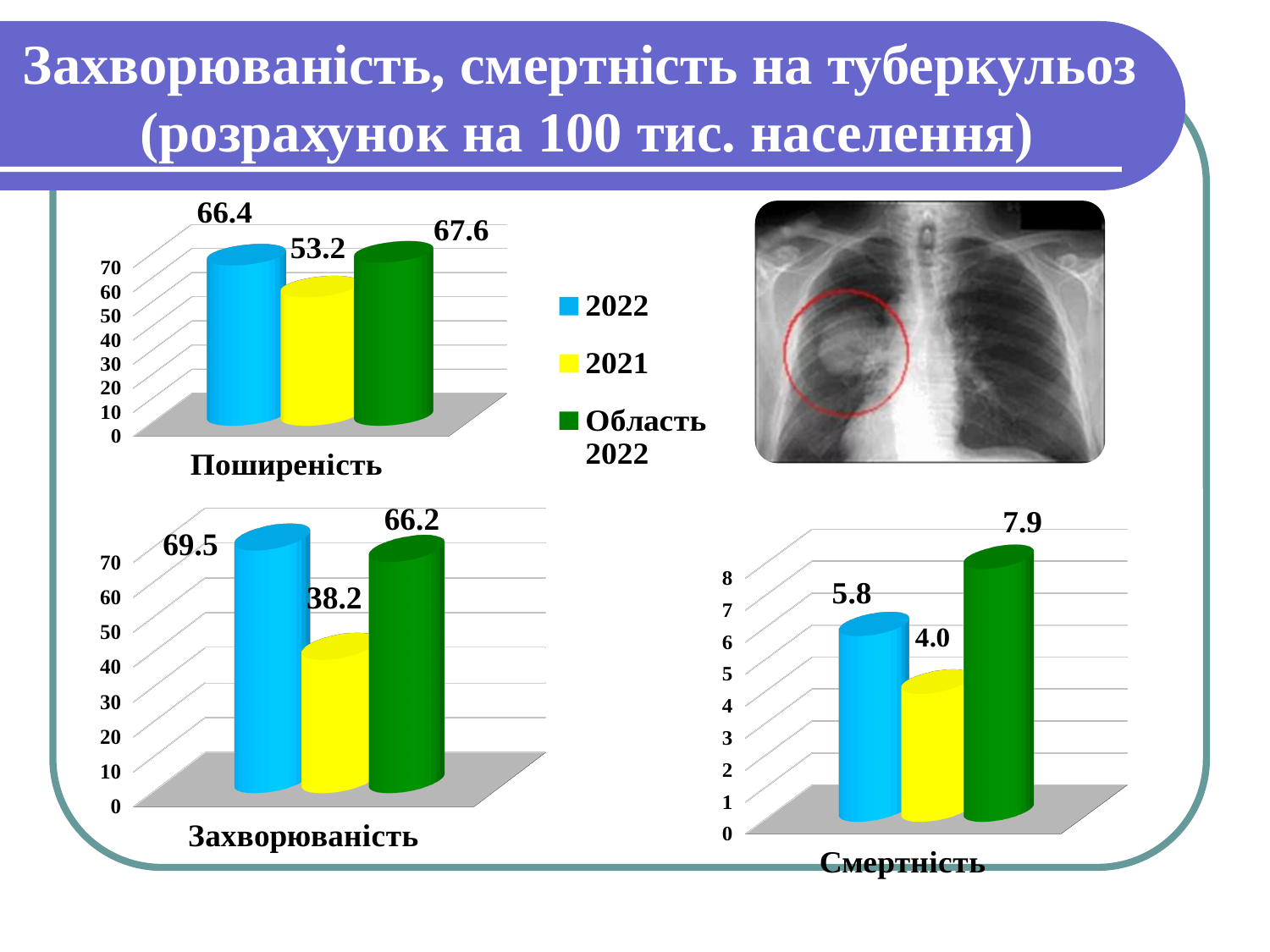
In the "Захворюваність" chart, what is the value for 2021? 38.2 In the "Поширеність" chart, what is the value for 2022? 66.4 In the "Поширеність" chart, which is larger: the value for 2022 or the value for 2021? 2022 In the "Захворюваність" chart, which series has the highest value? 2022 In the "Захворюваність" chart, what is the difference between the 2022 value and the 2021 value? 31.3 In the "Смертність" chart, what is the difference between the Область 2022 value and the 2022 value? 2.1 In the "Поширеність" chart, what is the value for 2021? 53.2 In the "Поширеність" chart, what is the value for Область 2022? 67.6 What kind of chart is the "Смертність" chart? Bar chart How many series does the legend list? 3 In the "Смертність" chart, which series has the lowest value? 2021 In the "Смертність" chart, what is the value for Область 2022? 7.9